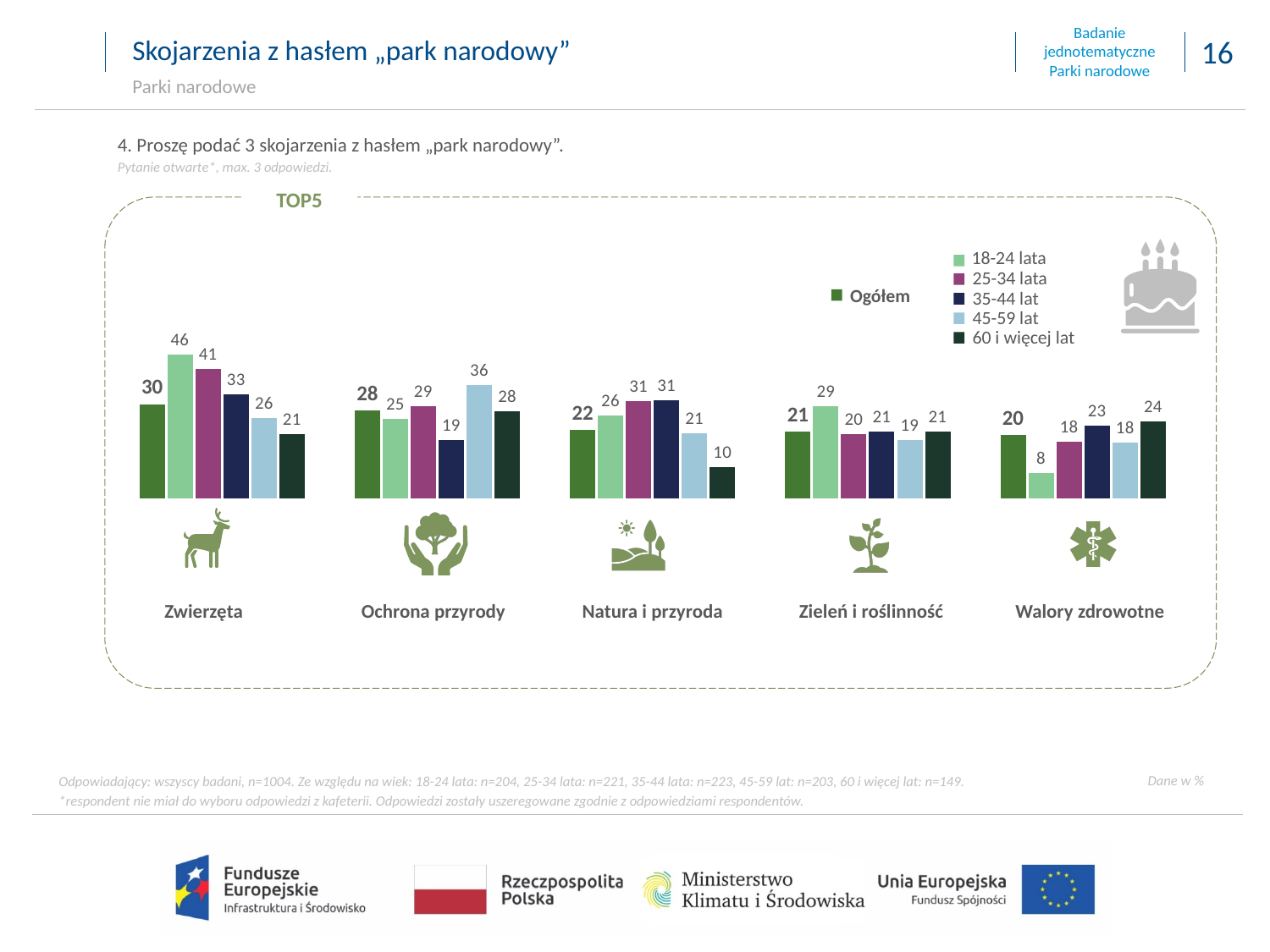
Which category has the lowest Ogółem value? Walory zdrowotne What is the value for the 45-59 lat group for Ochrona przyrody? 36 What is the value for the 60 i więcej lat group for Natura i przyroda? 10 What is the value for the 18-24 lata group for Walory zdrowotne? 8 What kind of chart is shown on the slide? Bar chart What is the Ogółem value for Zwierzęta? 30 Which category has the highest Ogółem value? Zwierzęta How many categories are shown in the chart? 5 What is the difference between the 18-24 lata value and the 60 i więcej lat value for Zwierzęta? 25 What is the value for the 18-24 lata group for Zwierzęta? 46 Which is larger for Walory zdrowotne: the 18-24 lata value or the 60 i więcej lat value? 60 i więcej lat How many series does the legend list? 6